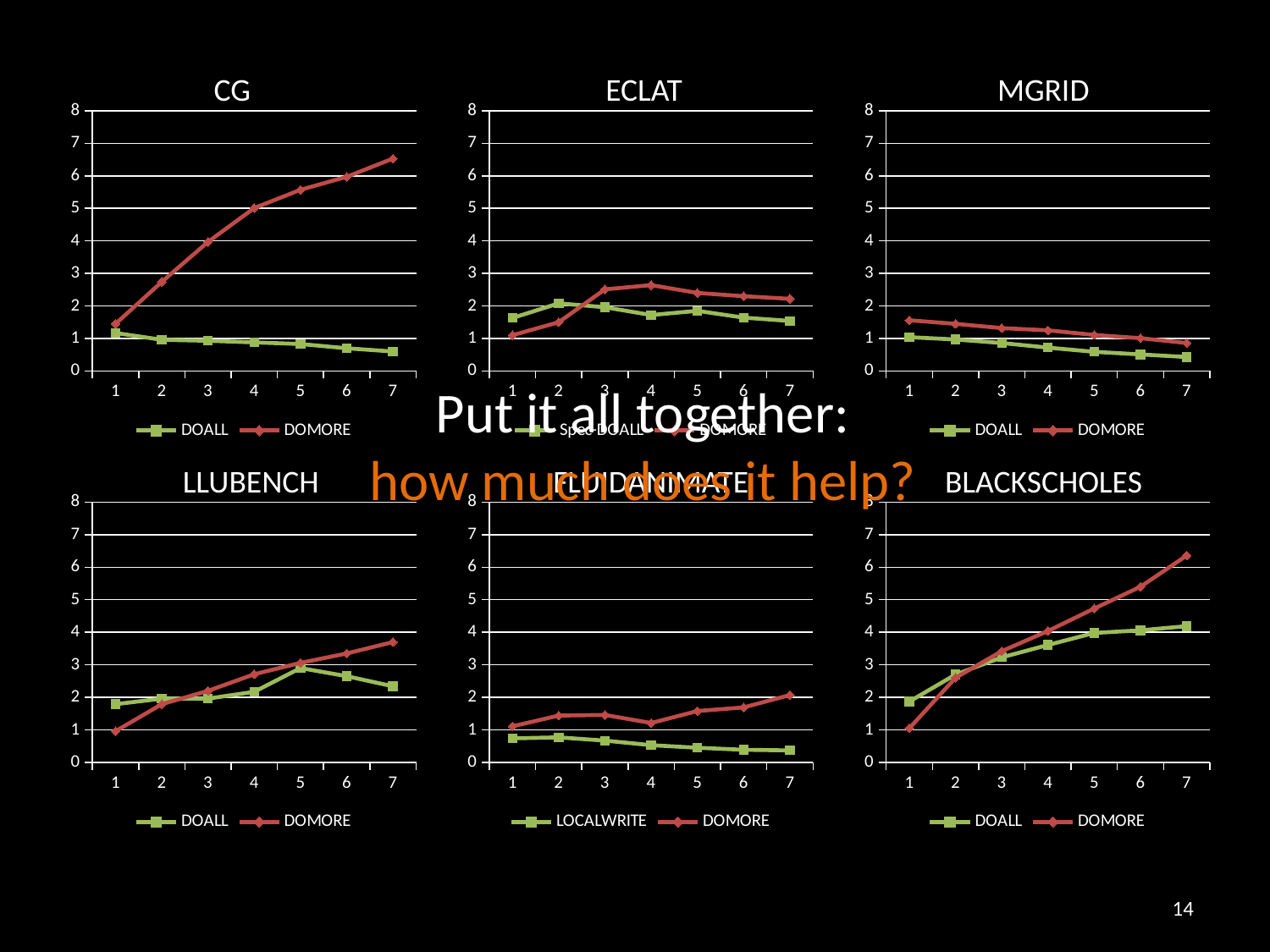
What kind of chart is the LLUBENCH chart? line chart How many x-axis points does the CG chart plot for each series? 7 In the CG chart, is the value of DOMORE at x = 2 greater or less than 3? less How many series does the legend of the bottom middle chart list? 2 In the BLACKSCHOLES chart, which series has the larger value at x = 1, DOALL or DOMORE? DOALL In the ECLAT chart, is the value of DOMORE at x = 4 greater or less than 2? greater In the MGRID chart, is the value of DOALL at x = 7 greater or less than 1? less In the MGRID chart, does the DOALL series rise or fall as x increases from 1 to 7? fall In the BLACKSCHOLES chart, which series has the larger value at x = 7, DOALL or DOMORE? DOMORE In the CG chart, does the DOMORE series rise or fall as x increases from 1 to 7? rise